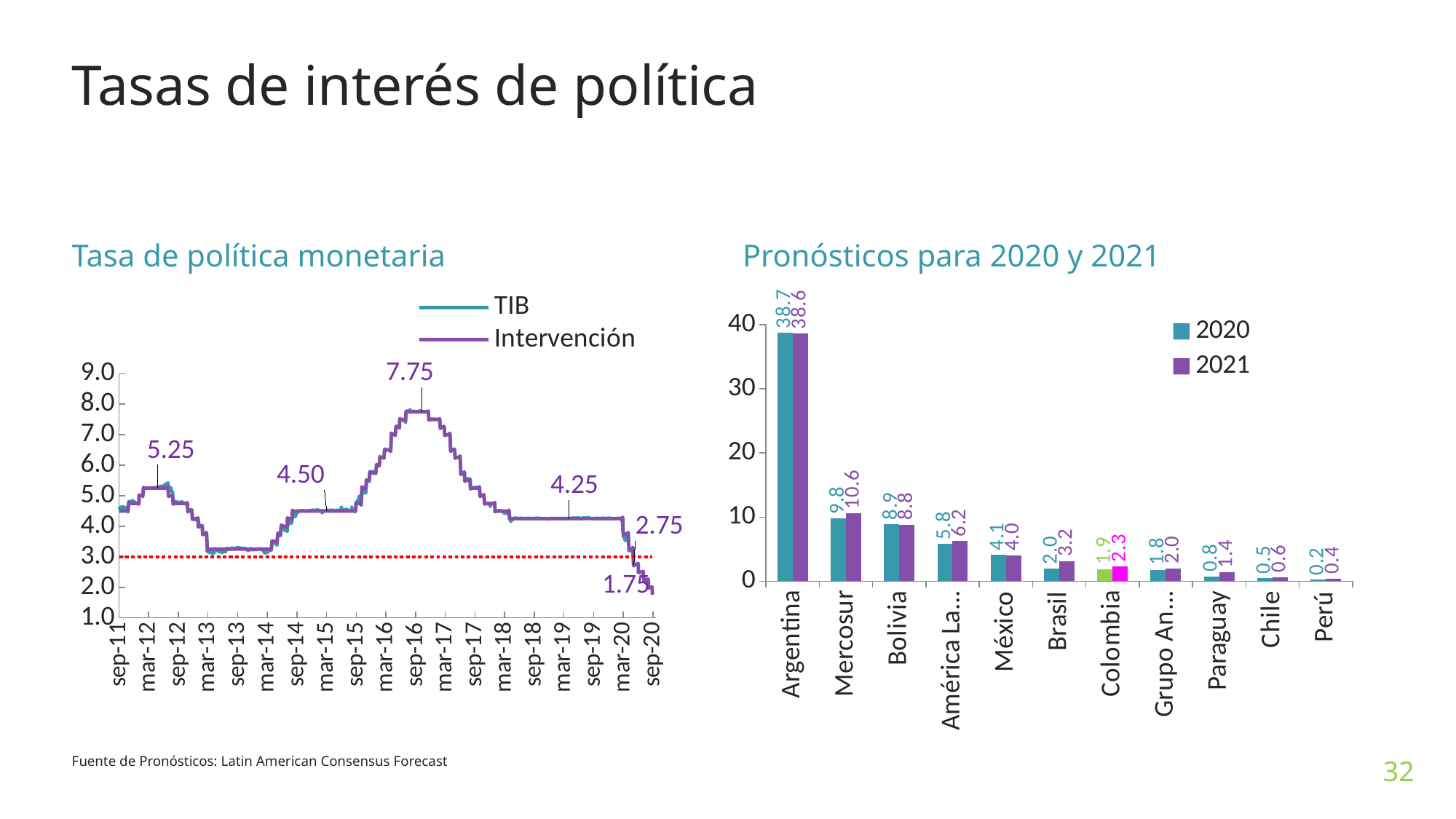
In the 'Pronósticos para 2020 y 2021' chart, which category has the highest 2020 forecast? Argentina How many categories are shown on the x axis of the 'Pronósticos para 2020 y 2021' chart? 11 In the 'Pronósticos para 2020 y 2021' chart, what is the 2021 forecast for Colombia? 2.3 In the 'Pronósticos para 2020 y 2021' chart, which category has the lowest 2021 forecast? Perú In the 'Pronósticos para 2020 y 2021' chart, what is the 2021 forecast for Argentina? 38.6 In the 'Pronósticos para 2020 y 2021' chart, what is the difference between the 2021 and 2020 forecasts for Brasil? 1.2 In the 'Tasa de política monetaria' chart, what is the last labelled value at the end of the series near sep-20? 1.75 In the 'Tasa de política monetaria' chart, what is the peak value labelled around sep-16? 7.75 In the 'Pronósticos para 2020 y 2021' chart, which is larger: the 2020 forecast for Bolivia or the 2020 forecast for México? Bolivia How many series does the legend of the 'Pronósticos para 2020 y 2021' chart list? 2 In the 'Pronósticos para 2020 y 2021' chart, what is the 2020 forecast for Mercosur? 9.8 What kind of chart is 'Tasa de política monetaria'? Line chart